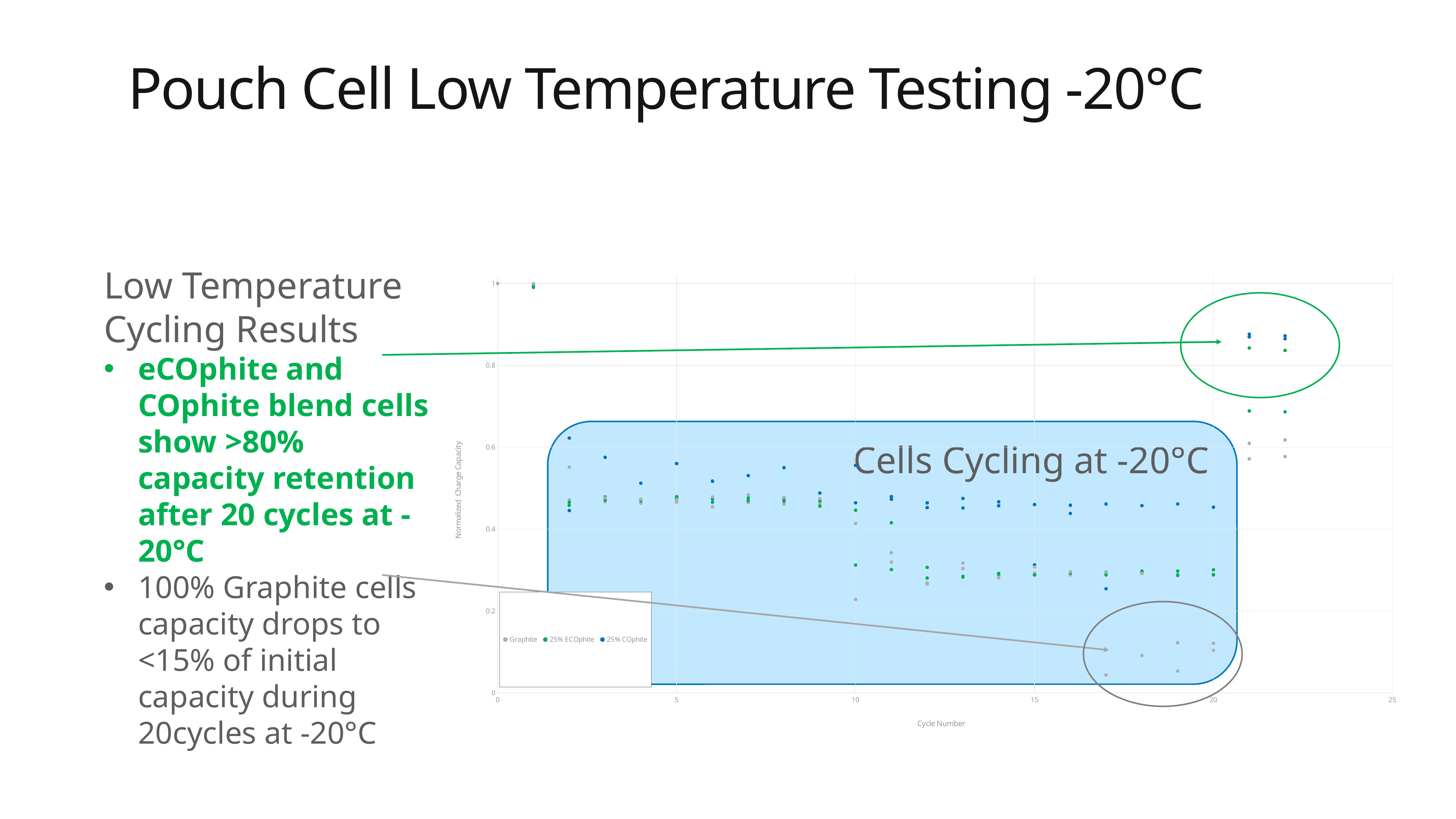
What are the three series listed in the chart legend? Graphite, 25% ECOphite, 25% COphite How many series does the chart legend list? 3 At cycle 20, which series has the larger value, Graphite or 25% COphite? 25% COphite Is the Graphite value at cycle 20 greater or less than 0.2? less At cycle 15, which series has the larger value, 25% COphite or 25% ECOphite? 25% COphite Is the Graphite value at cycle 2 greater or less than 0.4? greater Do the Graphite values rise or fall as the cycle number increases? fall What is the label of the x axis of the chart? Cycle Number Is the 25% COphite value at cycle 21 greater or less than 0.8? greater What kind of chart is shown on the slide? scatter chart